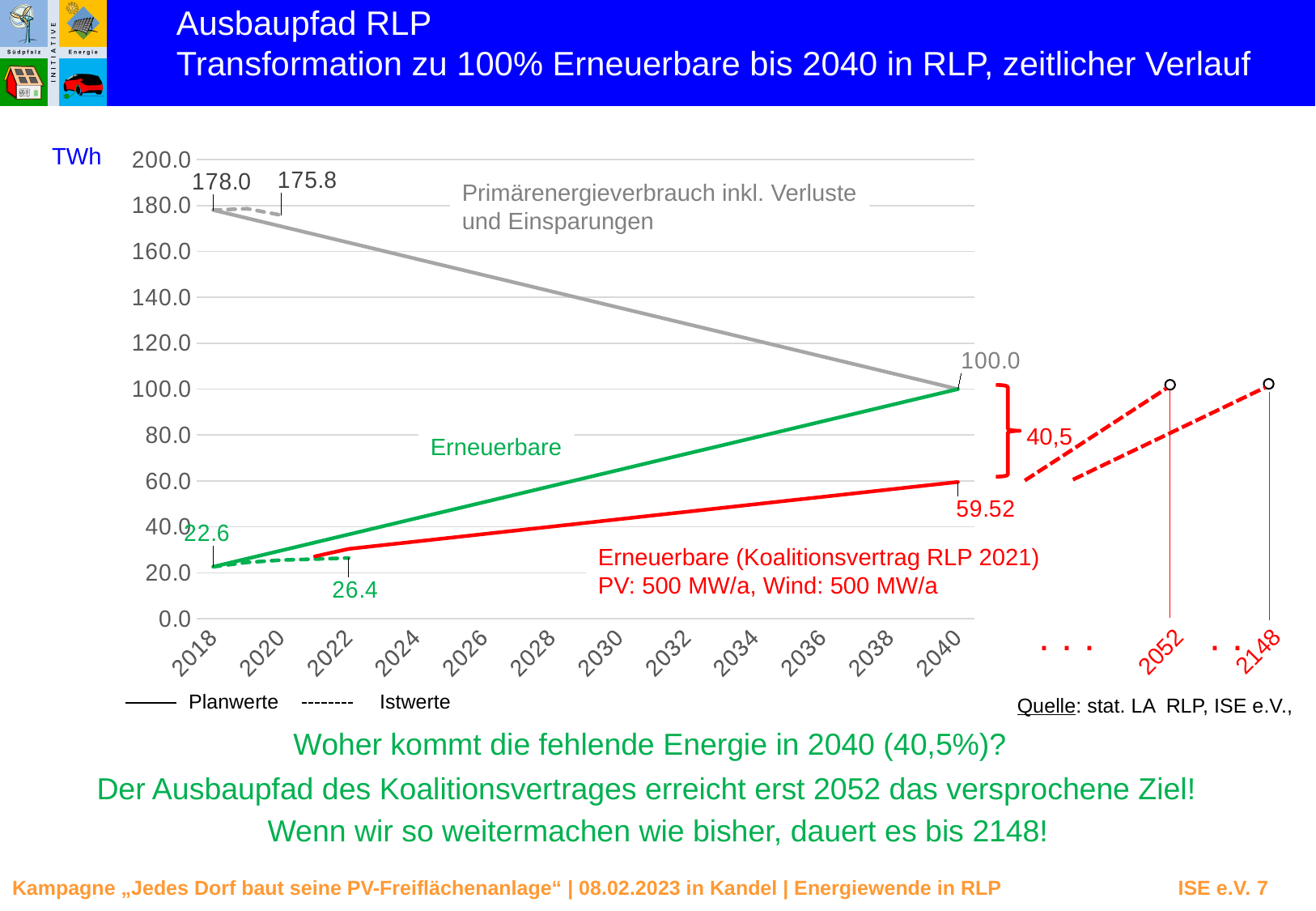
What is the difference between the 2018 plan value 178.0 and the actual value 175.8 for Primärenergieverbrauch? 2.2 What is the value of the Erneuerbare series in 2018? 22.6 What kind of chart is shown on the slide? line chart What is the value of Primärenergieverbrauch in 2040? 100.0 By how much does Primärenergieverbrauch decrease between 2018 and 2040? 78.0 What is the value of Primärenergieverbrauch in 2018? 178.0 What unit is shown on the y axis of the chart? TWh Is the value of the Erneuerbare line in 2030 greater or less than 40? greater In 2040, which is higher: the Erneuerbare line or the Erneuerbare (Koalitionsvertrag RLP 2021) line? Erneuerbare Does the Primärenergieverbrauch line rise or fall from 2018 to 2040? fall What value does the Erneuerbare (Koalitionsvertrag RLP 2021) line reach in 2040? 59.52